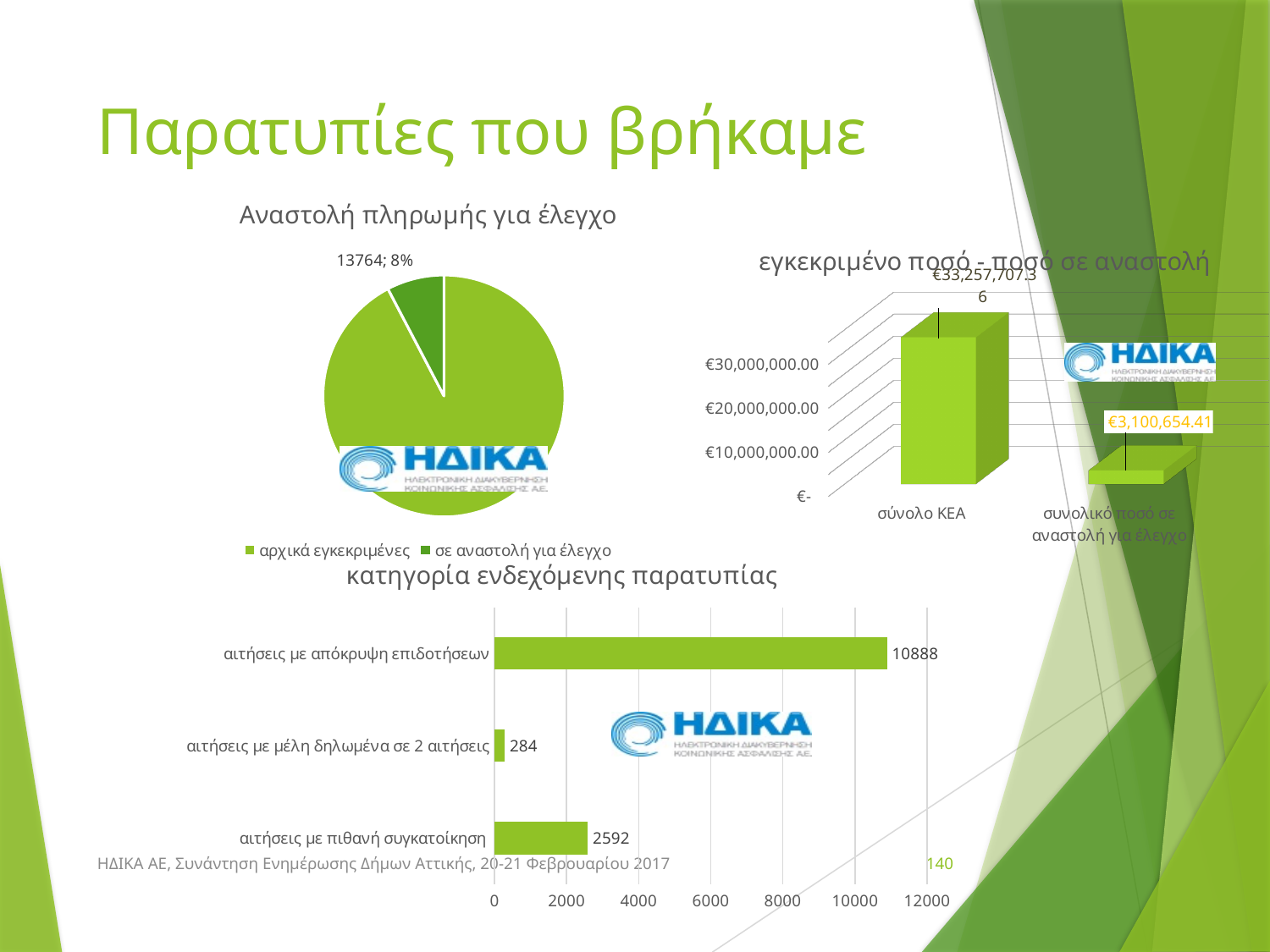
In the chart 'κατηγορία ενδεχόμενης παρατυπίας', what is the difference between 'αιτήσεις με απόκρυψη επιδοτήσεων' and 'αιτήσεις με πιθανή συγκατοίκηση'? 8296 In the chart 'κατηγορία ενδεχόμενης παρατυπίας', what is the value for 'αιτήσεις με απόκρυψη επιδοτήσεων'? 10888 In the chart 'κατηγορία ενδεχόμενης παρατυπίας', which category has the lowest value? αιτήσεις με μέλη δηλωμένα σε 2 αιτήσεις What kind of chart is 'κατηγορία ενδεχόμενης παρατυπίας'? bar chart In the chart 'εγκεκριμένο ποσό - ποσό σε αναστολή', is the value for 'σύνολο ΚΕΑ' greater or less than €30,000,000.00? greater In the chart 'κατηγορία ενδεχόμενης παρατυπίας', which category has the highest value? αιτήσεις με απόκρυψη επιδοτήσεων How many entries does the legend of the pie chart 'Αναστολή πληρωμής για έλεγχο' list? 2 In the chart 'εγκεκριμένο ποσό - ποσό σε αναστολή', what is the value for 'συνολικό ποσό σε αναστολή για έλεγχο'? €3,100,654.41 How many categories are shown in the chart 'κατηγορία ενδεχόμενης παρατυπίας'? 3 In the chart 'κατηγορία ενδεχόμενης παρατυπίας', what is the value for 'αιτήσεις με μέλη δηλωμένα σε 2 αιτήσεις'? 284 In the chart 'κατηγορία ενδεχόμενης παρατυπίας', what is the value for 'αιτήσεις με πιθανή συγκατοίκηση'? 2592 In the pie chart 'Αναστολή πληρωμής για έλεγχο', what share does the slice 'σε αναστολή για έλεγχο' have? 8%